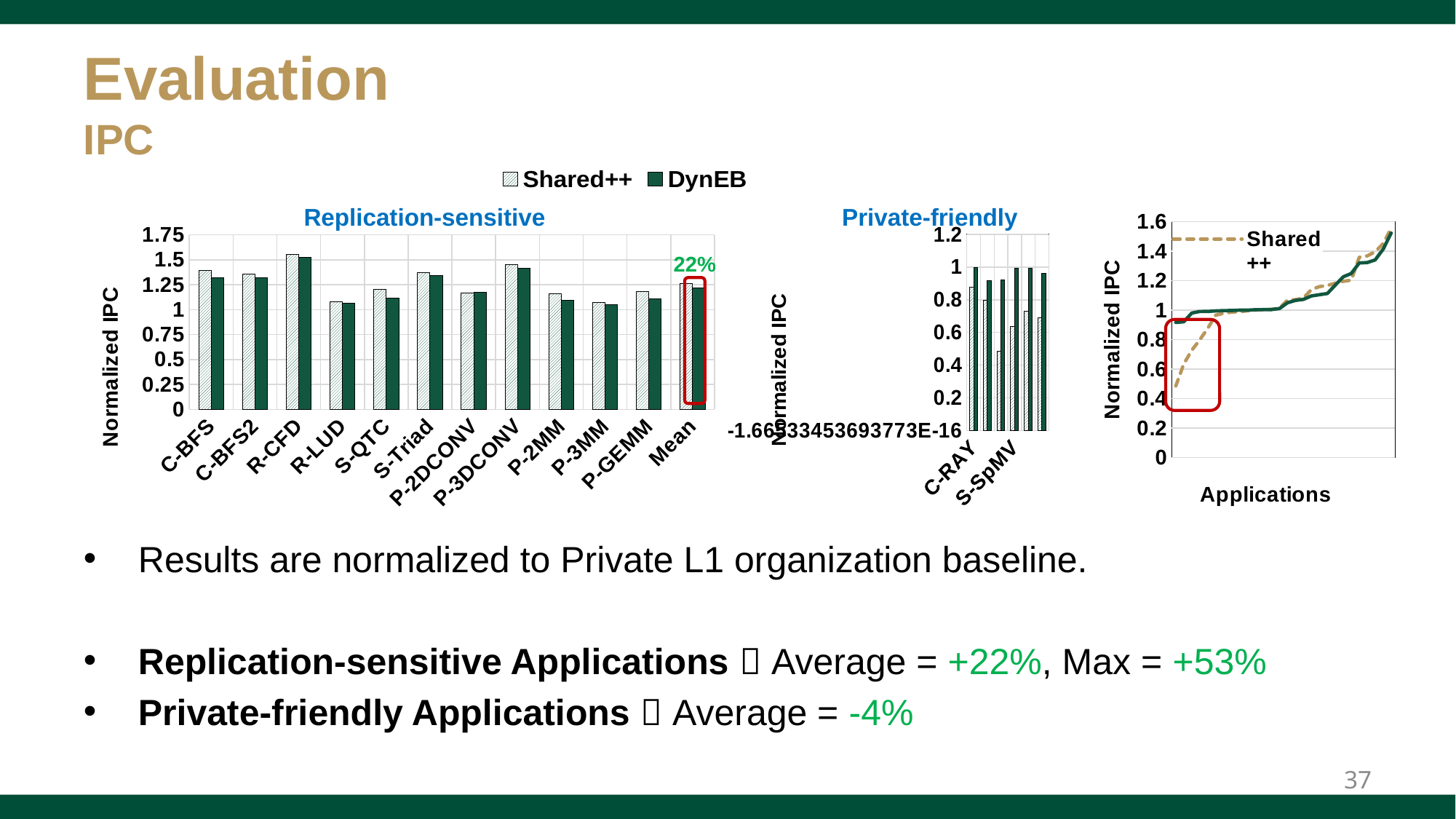
In the rightmost chart, do the Normalized IPC values rise or fall along the x axis? rise What type of chart is the Replication-sensitive chart? bar chart In the Replication-sensitive chart, what percentage is annotated above the Mean bars? 22% In the Replication-sensitive chart, which category has the highest Normalized IPC? R-CFD What type of chart is the rightmost chart with the x-axis labelled Applications? line chart In the Replication-sensitive chart, which is larger for P-2MM: the Shared++ value or the DynEB value? Shared++ In the Replication-sensitive chart, is the Shared++ value for R-LUD greater or less than 1.25? less What is the y-axis label of the Private-friendly chart? Normalized IPC In the Replication-sensitive chart, how many categories are shown on the x axis? 12 How many series does the legend above the bar charts list? 2 In the Replication-sensitive chart, is the DynEB value for P-3DCONV greater or less than 1.25? greater In the Replication-sensitive chart, is the Shared++ value for C-BFS greater or less than 1.25? greater